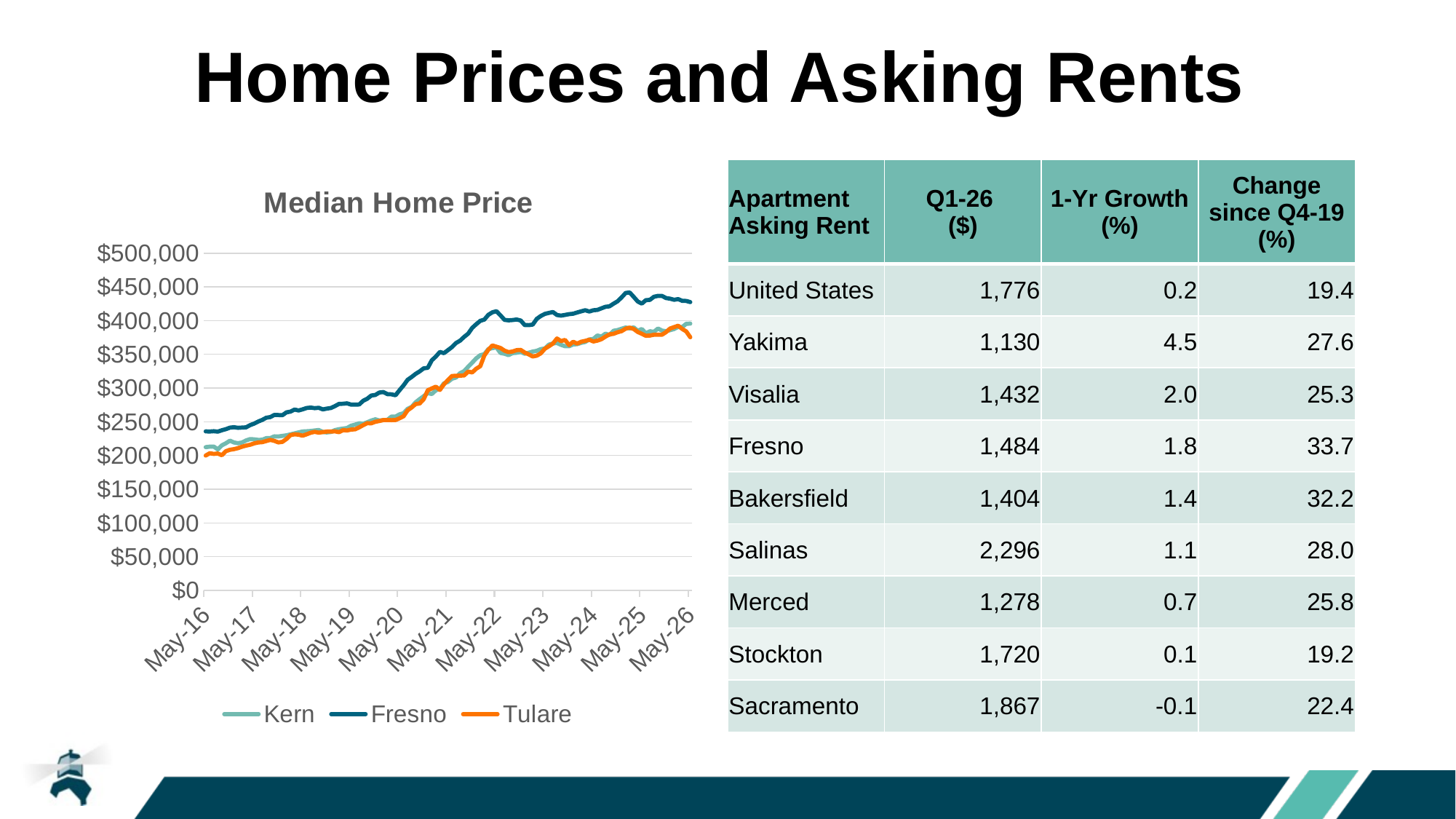
In the Median Home Price chart, is the Fresno value at May-26 greater or less than $400,000? greater What kind of chart is the Median Home Price chart? line chart In the Median Home Price chart, which series has the lowest value at May-26? Tulare In the Median Home Price chart, is the Fresno value at May-16 greater or less than $200,000? greater In the Median Home Price chart, which series has the highest value at May-26? Fresno Do median home prices in the Median Home Price chart generally rise or fall from May-16 to May-26? rise What is the title of the chart on the slide? Median Home Price Which series are shown in the legend of the Median Home Price chart? Kern, Fresno, Tulare How many series does the legend of the Median Home Price chart list? 3 In the Median Home Price chart, which is higher at May-16: Fresno or Kern? Fresno In the Median Home Price chart, is the Fresno value at May-26 greater or less than $450,000? less